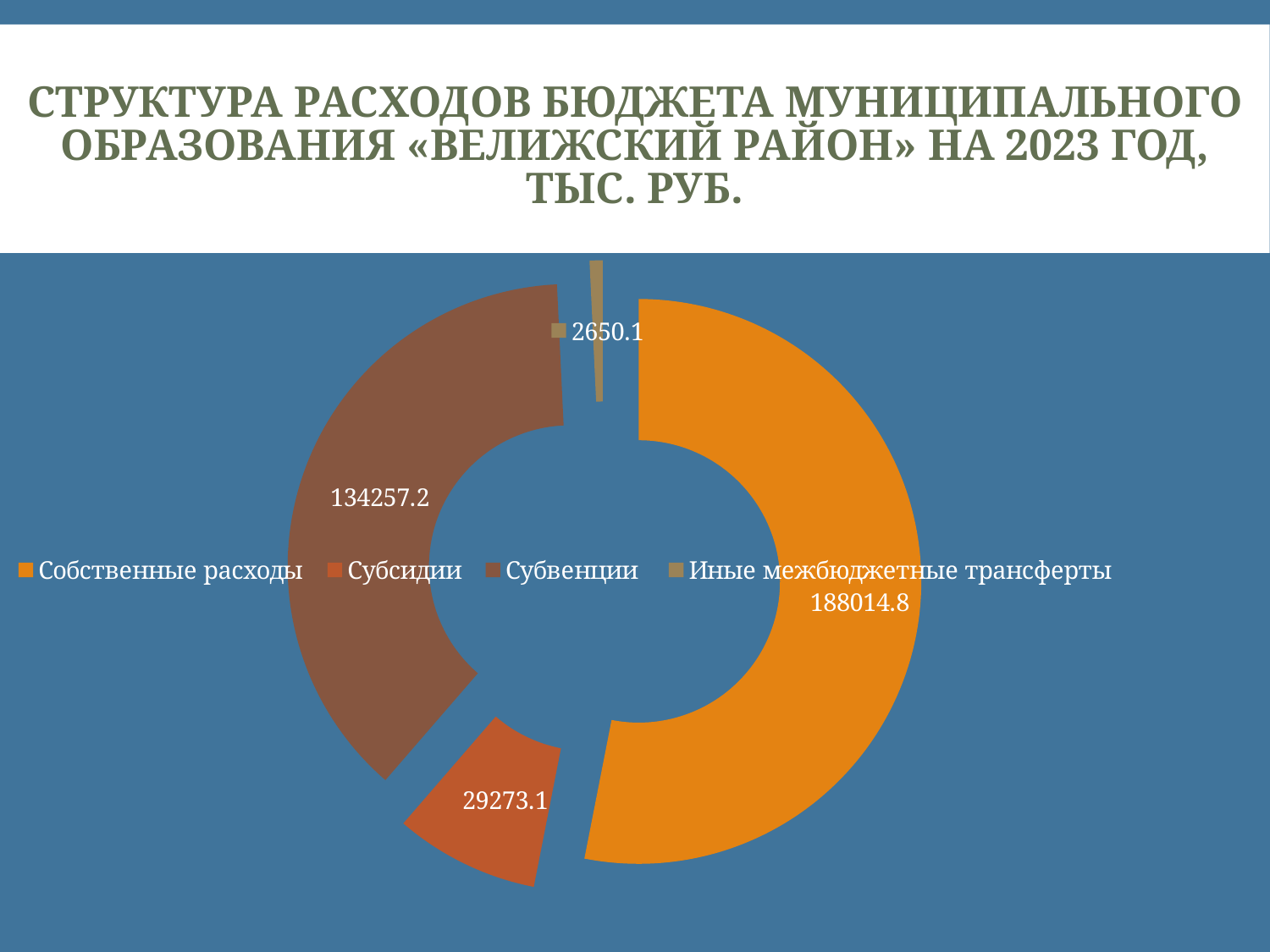
What is the value for Иные межбюджетные трансферты? 2650.1 Which category has the largest value? Собственные расходы What is the difference between Субвенции and Субсидии? 104984.1 What kind of chart is shown on the slide? doughnut chart What is the total of all four categories shown in the chart? 354195.2 Which category has the smallest value? Иные межбюджетные трансферты What is the value for Собственные расходы? 188014.8 Which is larger, Субсидии or Субвенции? Субвенции How many categories does the chart show? 4 What is the difference between Собственные расходы and Субвенции? 53757.6 What is the value for Субсидии? 29273.1 What is the value for Субвенции? 134257.2